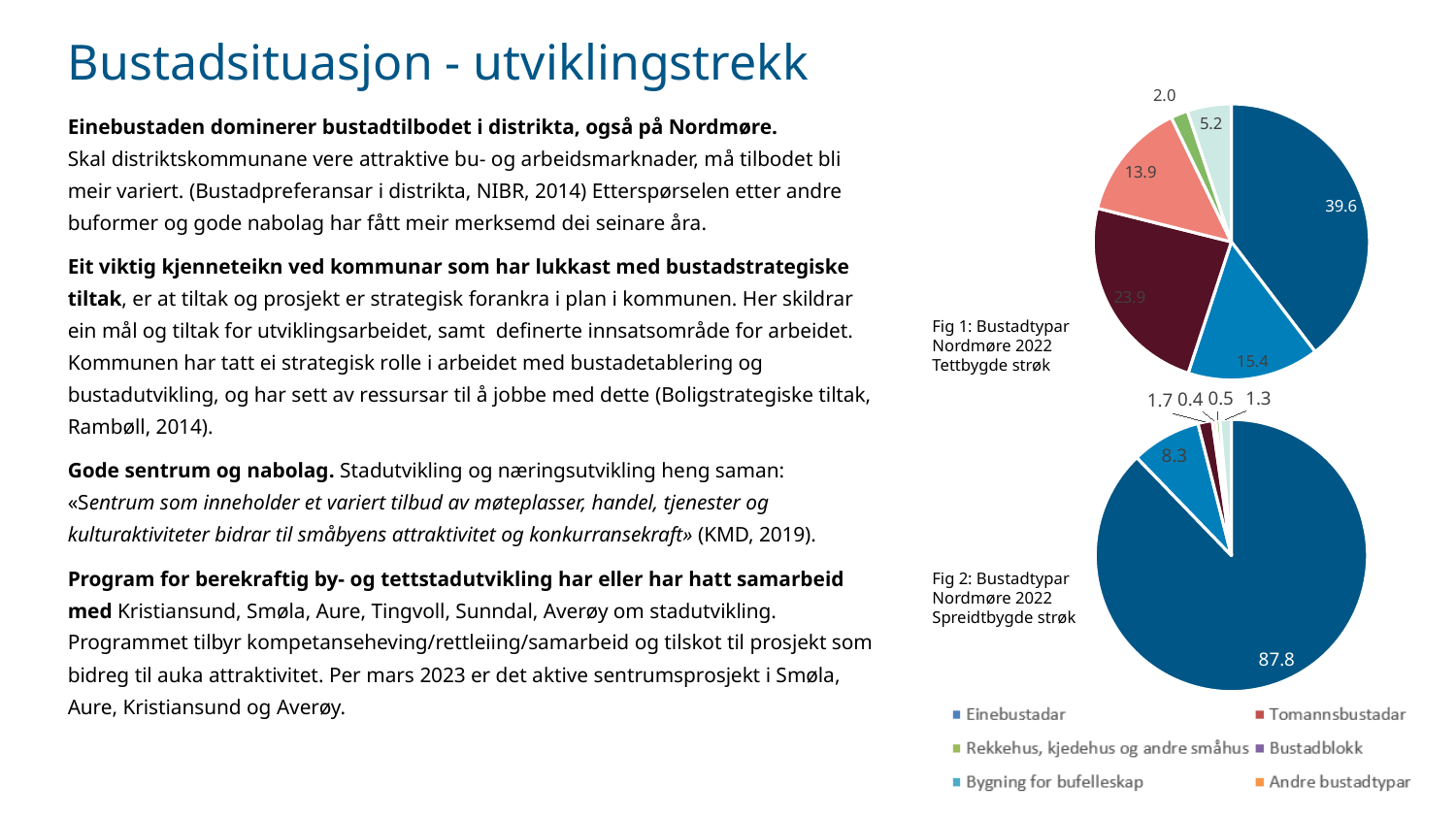
In Fig 1 (Tettbygde strøk), what is the value of the largest slice? 39.6 Is the Einebustadar share larger in Fig 1 (Tettbygde strøk) or in Fig 2 (Spreidtbygde strøk)? Fig 2 (Spreidtbygde strøk) What is the value for Einebustadar in Fig 2 (Spreidtbygde strøk)? 87.8 What kind of chart is Fig 1: Bustadtypar Nordmøre 2022 Tettbygde strøk? Pie chart In Fig 2 (Spreidtbygde strøk), what is the value of the smallest slice? 0.4 In Fig 1 (Tettbygde strøk), what is the difference between the largest slice (39.6) and the second largest slice (23.9)? 15.7 In Fig 1 (Tettbygde strøk), what is the value of the smallest slice? 2.0 What is the difference between the Einebustadar value in Fig 2 (87.8) and in Fig 1 (39.6)? 48.2 What is the value for Einebustadar in Fig 1 (Tettbygde strøk)? 39.6 How many entries does the shared legend below the pie charts list? 6 In Fig 2 (Spreidtbygde strøk), what is the value of the largest slice? 87.8 How many slices does Fig 1 (Tettbygde strøk) have? 6